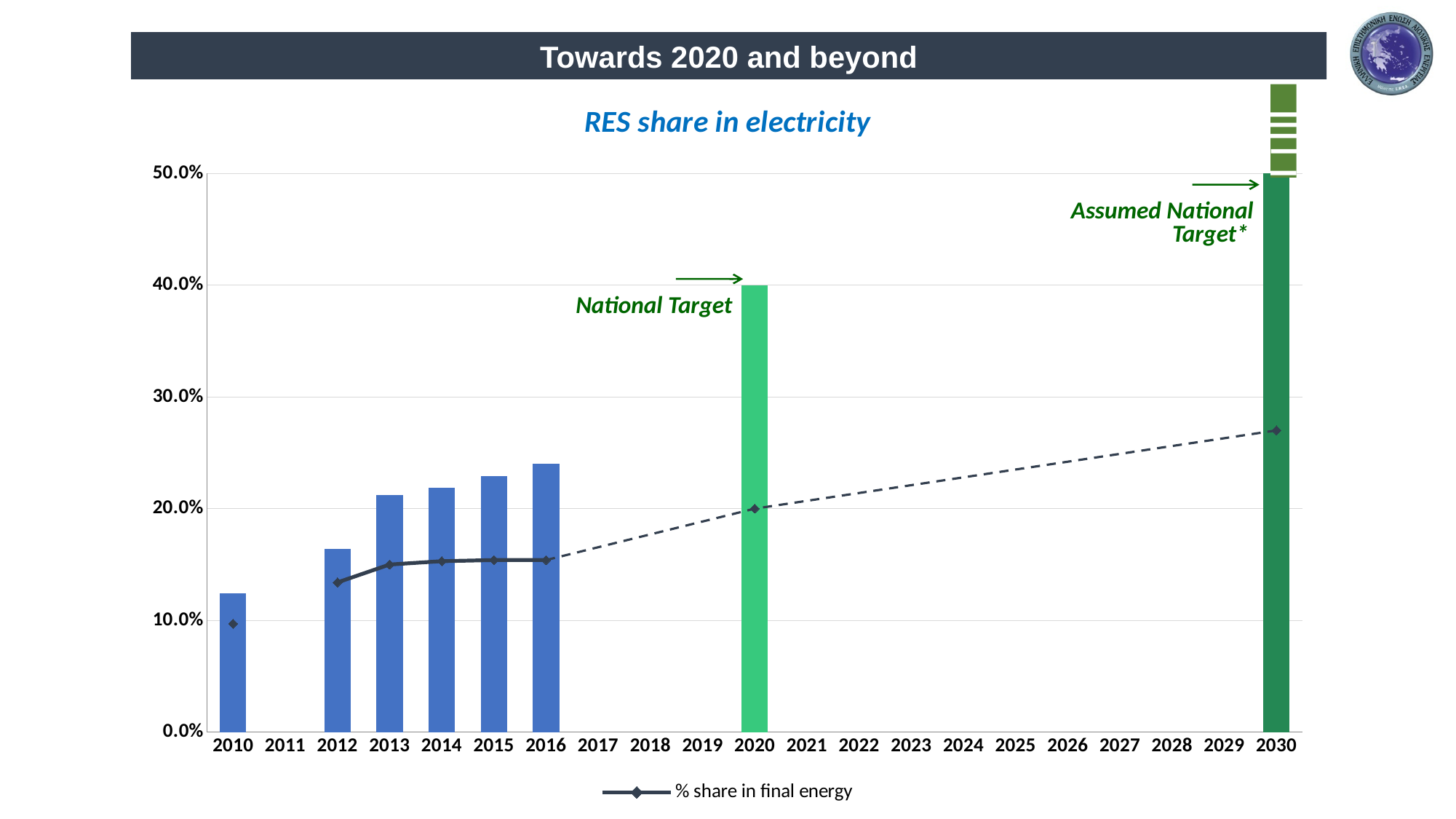
What kind of chart is shown on the slide? Bar chart with a line What is the value of the bar for 2030? 50.0% What series does the legend list? % share in final energy Is the bar for 2010 greater or less than 10.0%? greater What is the value of the % share in final energy line at 2020? 20.0% Which year has the highest bar? 2030 Do the bars rise or fall from 2010 to 2016? rise What is the title of the chart? RES share in electricity What is the difference between the bar for 2030 and the bar for 2020? 10.0% What is the value of the bar for 2020? 40.0% Which year has the lowest bar? 2010 Is the bar for 2016 greater or less than 30.0%? less